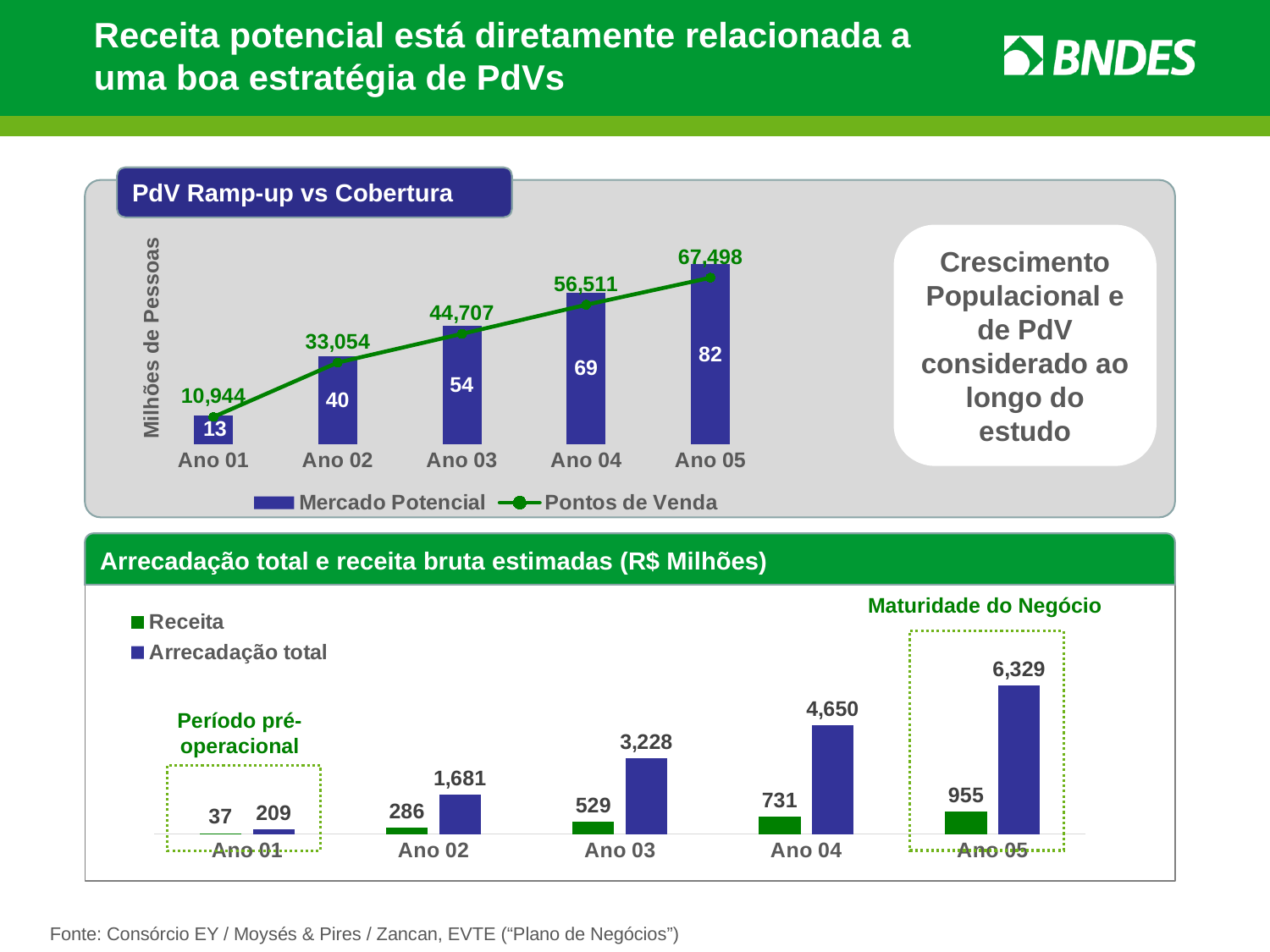
In the 'Arrecadação total e receita bruta estimadas' chart, which year has the lowest Receita value? Ano 01 What type of chart is the 'Arrecadação total e receita bruta estimadas' chart? bar chart In the 'PdV Ramp-up vs Cobertura' chart, do the Pontos de Venda values rise or fall from Ano 01 to Ano 05? rise In the 'Arrecadação total e receita bruta estimadas' chart, what is the Arrecadação total value for Ano 04? 4,650 In the 'Arrecadação total e receita bruta estimadas' chart, what is the Receita value for Ano 02? 286 In the 'PdV Ramp-up vs Cobertura' chart, how many series does the legend list? 2 In the 'PdV Ramp-up vs Cobertura' chart, what is the difference in Mercado Potencial between Ano 05 and Ano 01? 69 In the 'PdV Ramp-up vs Cobertura' chart, what is the Pontos de Venda value for Ano 02? 33,054 In the 'Arrecadação total e receita bruta estimadas' chart, how many years are shown on the x axis? 5 In the 'PdV Ramp-up vs Cobertura' chart, which year has the highest Pontos de Venda value? Ano 05 In the 'PdV Ramp-up vs Cobertura' chart, what is the Mercado Potencial value for Ano 03? 54 In the 'Arrecadação total e receita bruta estimadas' chart, what is the difference between Arrecadação total and Receita in Ano 05? 5,374